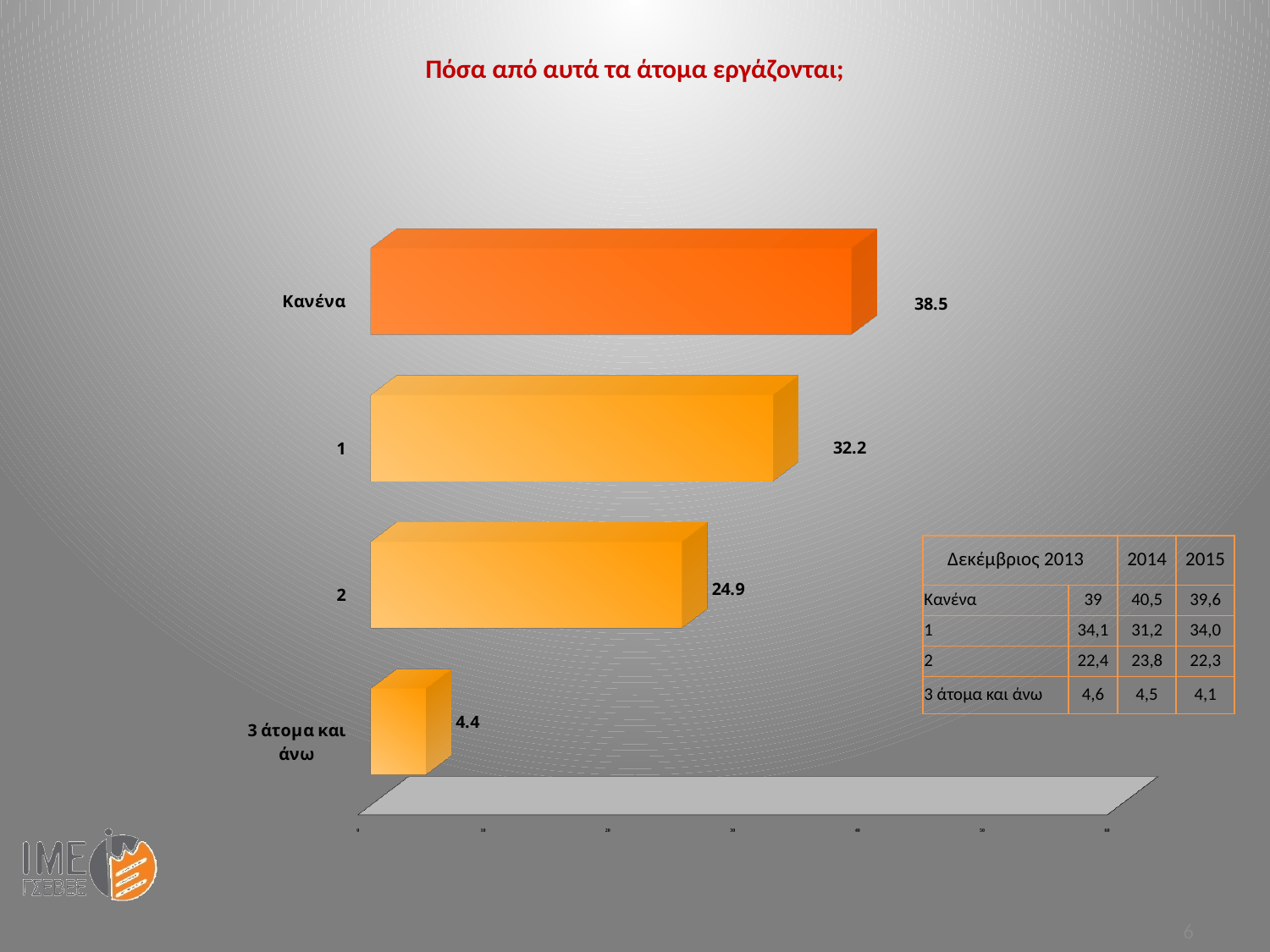
What is the difference between the values for Κανένα and 1? 6.3 What kind of chart is shown on the slide? bar chart Which category has the highest value? Κανένα What is the title of the slide? Πόσα από αυτά τα άτομα εργάζονται; How many categories are shown in the bar chart? 4 What is the value for the category 1? 32.2 What is the difference between the values for 2 and 3 άτομα και άνω? 20.5 What is the value for the category 2? 24.9 What is the value for Κανένα? 38.5 Which category has the lowest value? 3 άτομα και άνω What is the value for 3 άτομα και άνω? 4.4 Which is larger, the value for 1 or the value for 2? 1